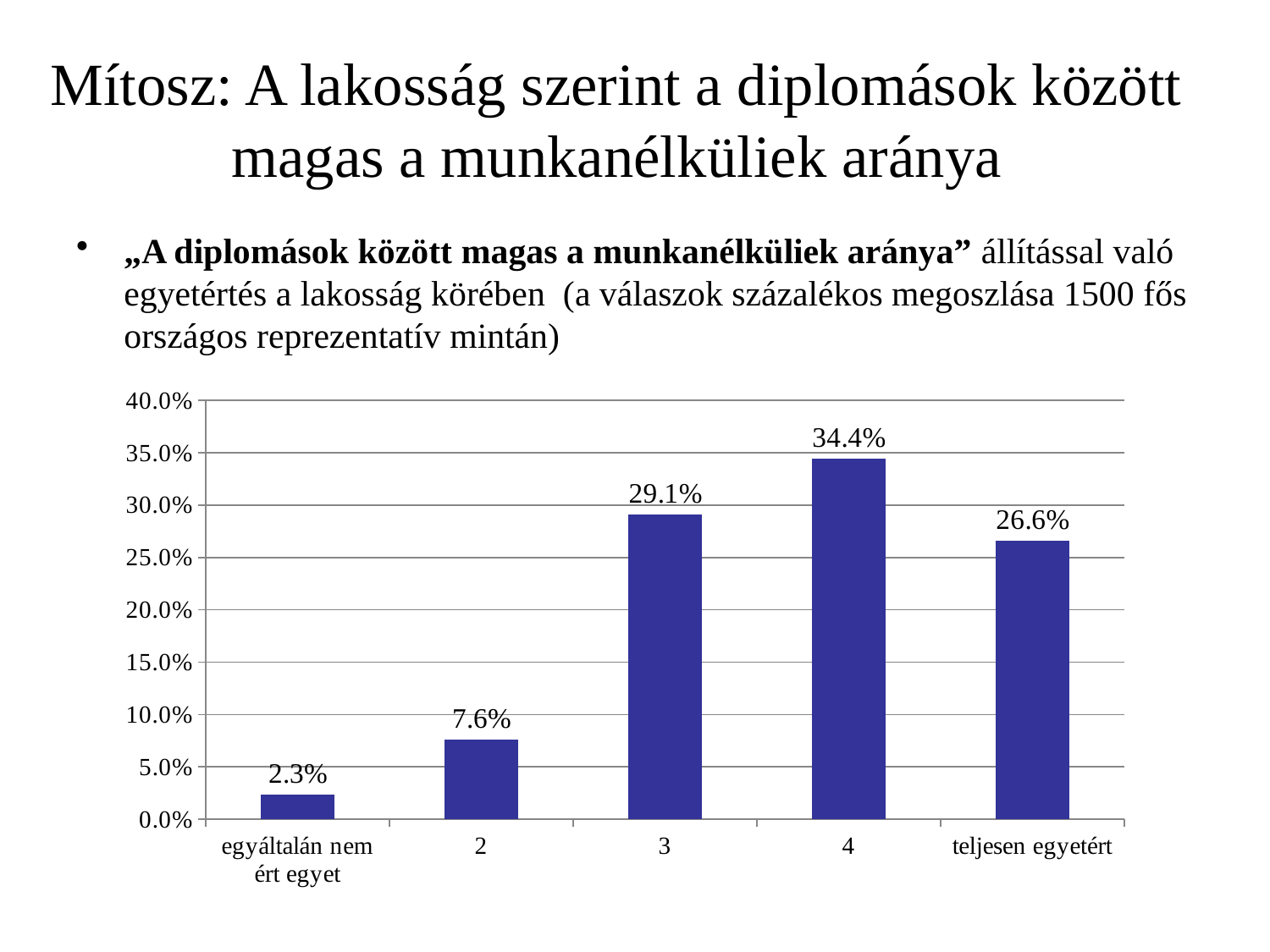
What is the value for the category "egyáltalán nem ért egyet"? 2.3% What is the value for "teljesen egyetért"? 26.6% Which is larger, the value for category 3 or for "teljesen egyetért"? 3 Is the value for category 2 greater or less than 10.0%? less What kind of chart is shown on the slide? bar chart What is the total of the values for category 2 and category 3? 36.7% What is the highest value shown on the y axis? 40.0% Which category has the lowest value? egyáltalán nem ért egyet Which category has the highest value? 4 How many categories are shown on the x axis? 5 What is the difference between the values for category 4 and category 3? 5.3% What is the value for category 4? 34.4%